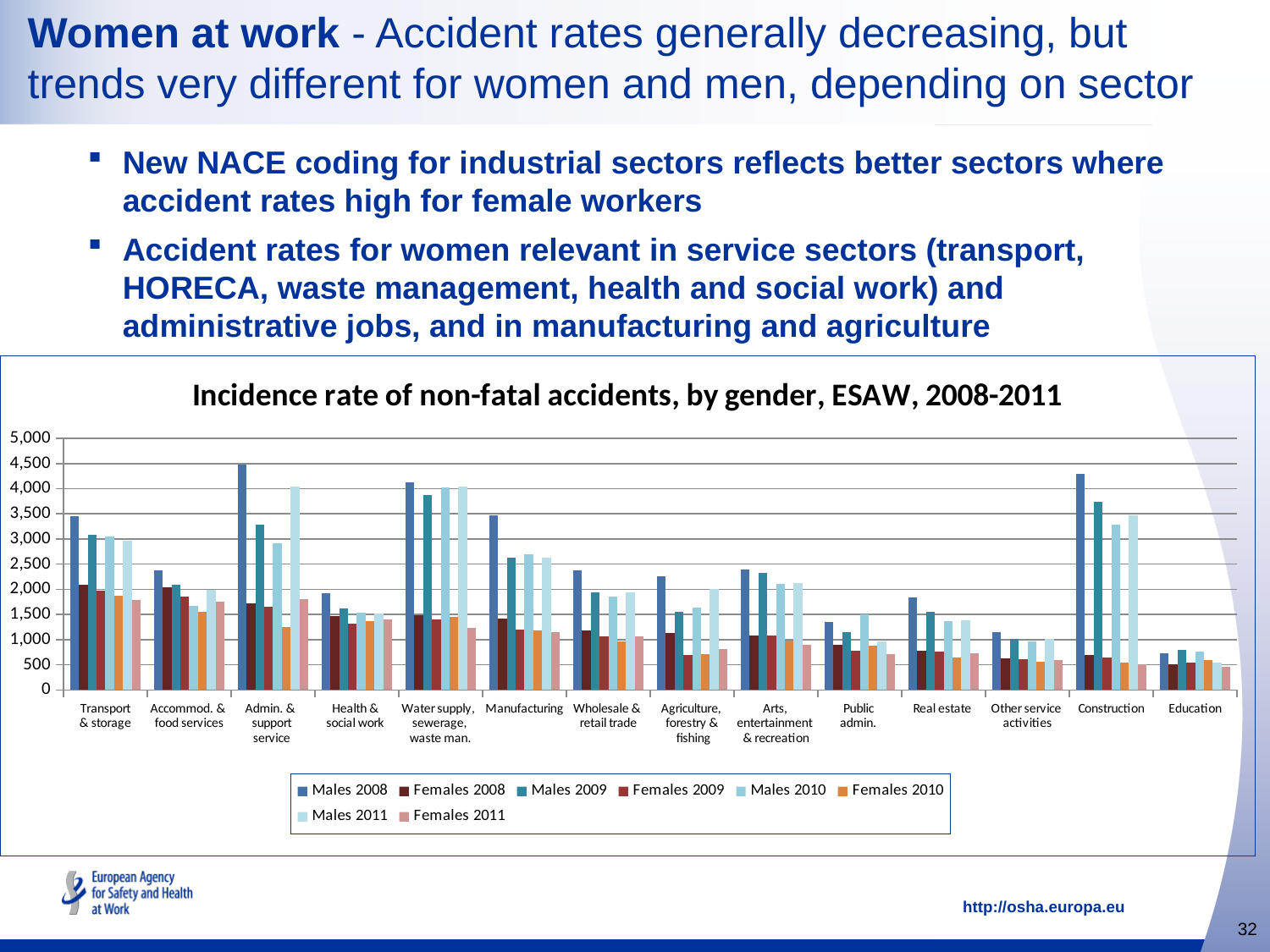
What is the title of the chart? Incidence rate of non-fatal accidents, by gender, ESAW, 2008-2011 How many sector categories are shown on the x axis of the chart? 14 Is the Females 2010 value for Agriculture, forestry & fishing greater or less than 1,000? less What kind of chart is shown on the slide? Bar chart Is the Males 2008 value for Construction greater or less than 4,000? greater Which sector has the highest Males 2008 value? Admin. & support service Which sector has the lowest Males 2008 value? Education Which is larger for Admin. & support service: the Males 2008 value or the Females 2008 value? Males 2008 How many series does the chart legend list? 8 For Transport & storage, do the male values rise or fall from 2008 to 2011? fall Is the Males 2008 value for Transport & storage greater or less than 3,000? greater